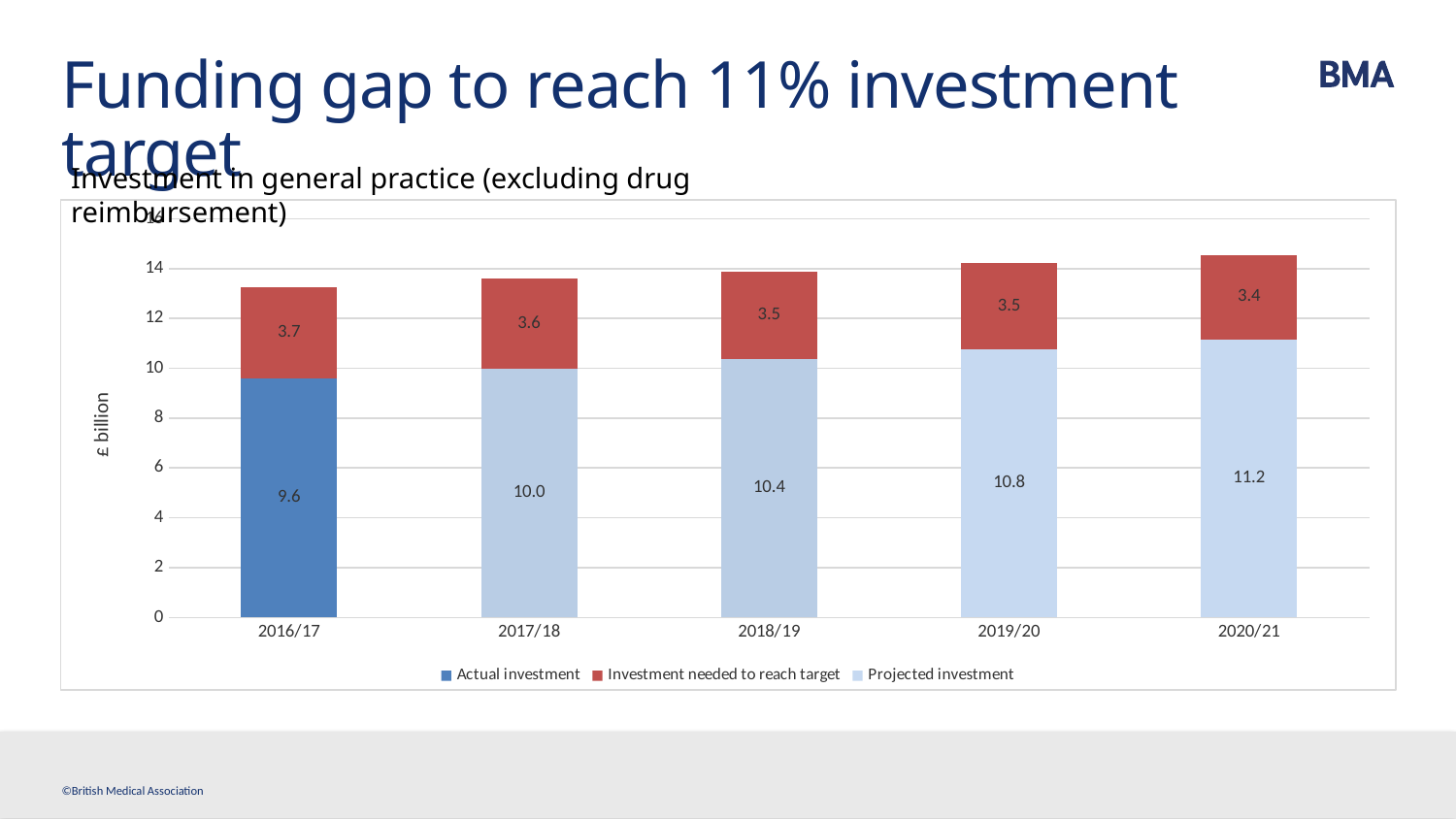
What is the investment needed to reach target in 2018/19? 3.5 What is the total height of the stacked bar for 2019/20? 14.3 Which year has the lowest investment needed to reach target? 2020/21 Which year has the highest projected investment? 2020/21 What kind of chart is shown on the slide? Stacked bar chart What is the difference between the projected investment in 2020/21 and the actual investment in 2016/17? 1.6 Is the investment needed to reach target larger in 2016/17 or in 2020/21? 2016/17 How many years are shown on the x axis? 5 What is the projected investment value for 2020/21? 11.2 How many series does the legend list? 3 What is the actual investment value for 2016/17? 9.6 What unit is shown on the y axis label? £ billion